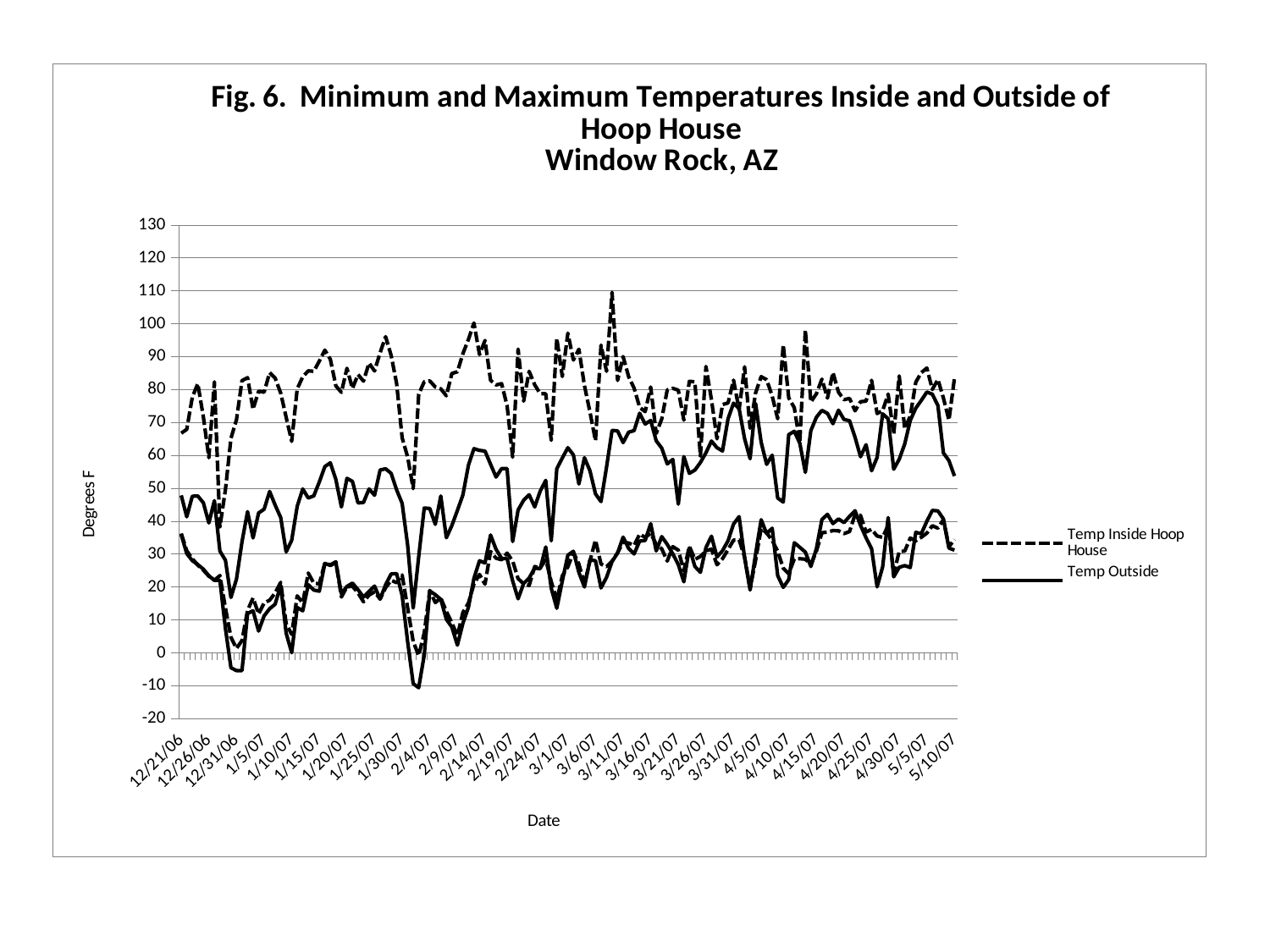
Is the highest value reached by the solid Temp Outside maximum line greater or less than 90? less Do the minimum temperature lines generally rise or fall from early February to May? rise Is the highest peak of the dashed Temp Inside Hoop House maximum line (around 3/11/07) greater or less than 100? greater What is the lowest value shown on the y axis? -20 Which line style represents Temp Inside Hoop House in the legend? dashed What kind of chart is shown on the slide? line chart What is the title of the chart? Fig. 6. Minimum and Maximum Temperatures Inside and Outside of Hoop House Window Rock, AZ Which is higher over the period, the maximum temperature inside the hoop house or the maximum temperature outside? Temp Inside Hoop House How many series does the legend list? 2 Is the lowest point of the solid Temp Outside minimum line (around 2/4/07) greater or less than 0? less